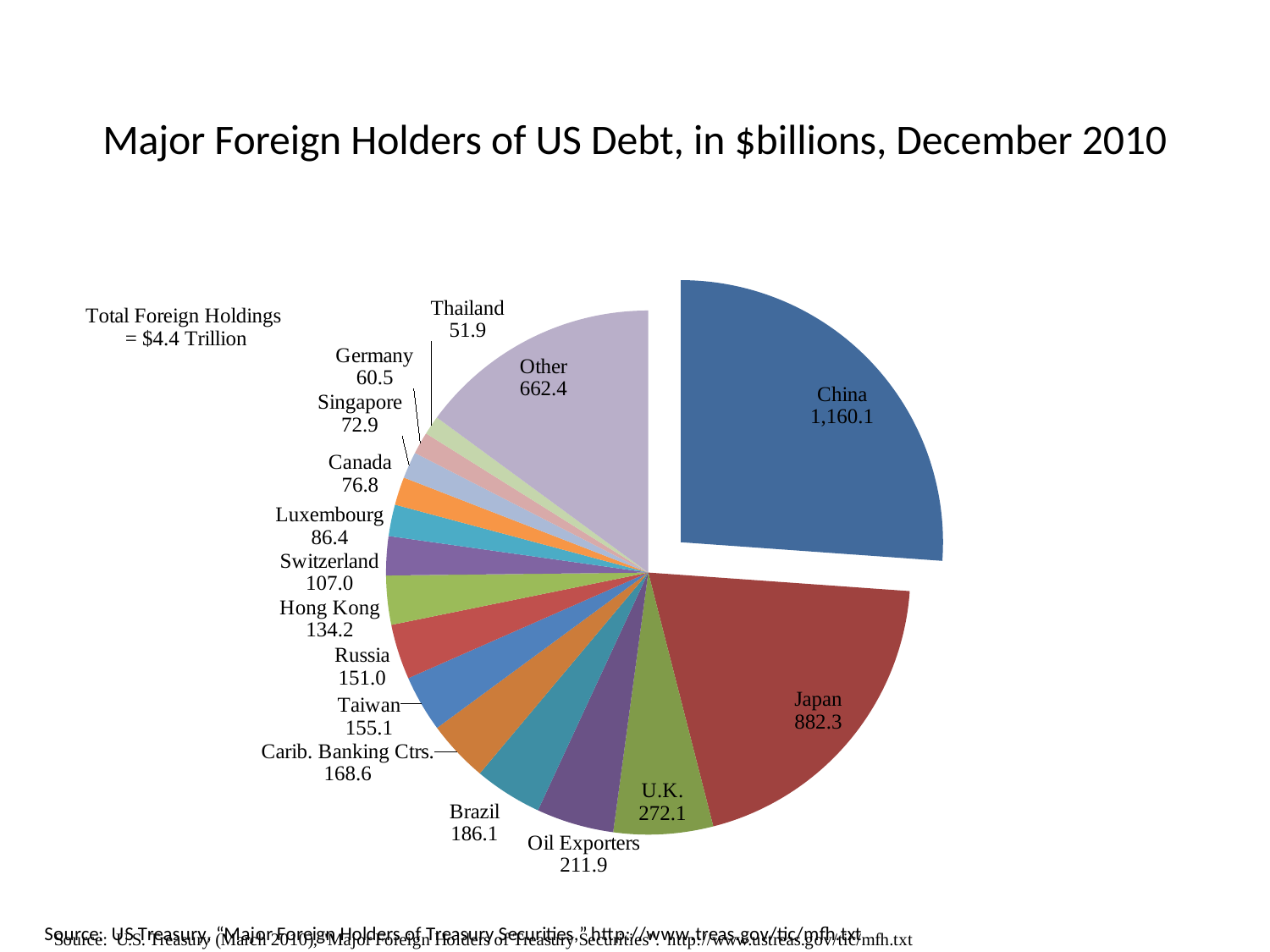
What is the value for China? 1,160.1 What is the value for Carib. Banking Ctrs.? 168.6 What is the value for Japan? 882.3 What is the title of the chart? Major Foreign Holders of US Debt, in $billions, December 2010 Which named holder has the smallest slice of the pie? Thailand What is the difference between the values for Japan and the U.K.? 610.2 What is the difference between the values for China and Japan? 277.8 What is the value for Oil Exporters? 211.9 Which is larger, the value for Brazil or the value for Carib. Banking Ctrs.? Brazil How many slices does the pie chart have? 16 What kind of chart is shown on the slide? Pie chart Which holder has the largest slice of the pie? China